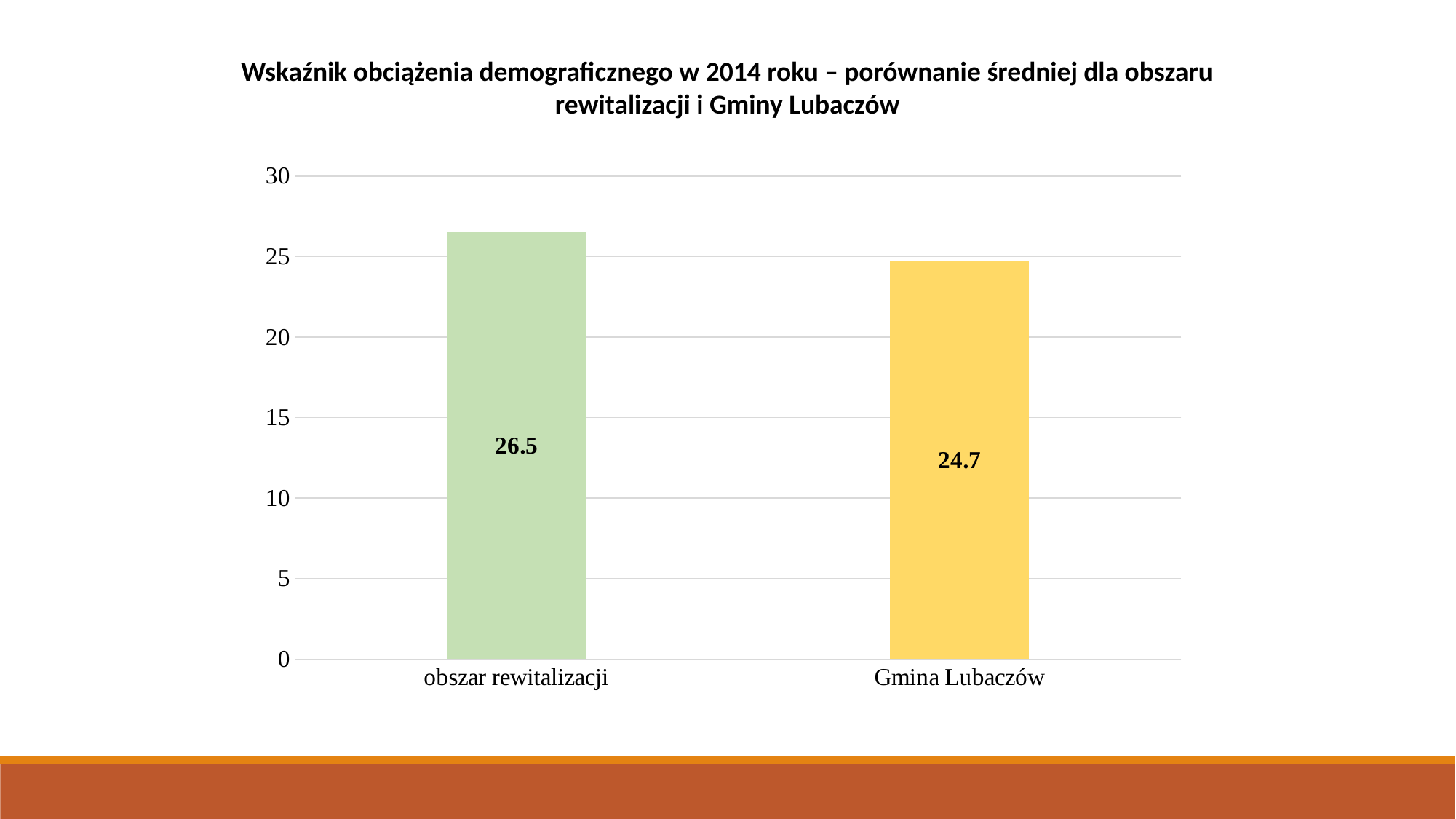
Which category has the highest value? obszar rewitalizacji What is the highest value shown on the vertical axis? 30 Which is larger, the value for obszar rewitalizacji or the value for Gmina Lubaczów? obszar rewitalizacji Which category has the lowest value? Gmina Lubaczów What is the difference between the values for obszar rewitalizacji and Gmina Lubaczów? 1.8 How many categories are shown on the chart? 2 Is the value for Gmina Lubaczów greater or less than 25? less What kind of chart is shown on the slide? bar chart What colour is the bar for Gmina Lubaczów? yellow Is the value for obszar rewitalizacji greater or less than 25? greater What is the value for obszar rewitalizacji? 26.5 What is the value for Gmina Lubaczów? 24.7